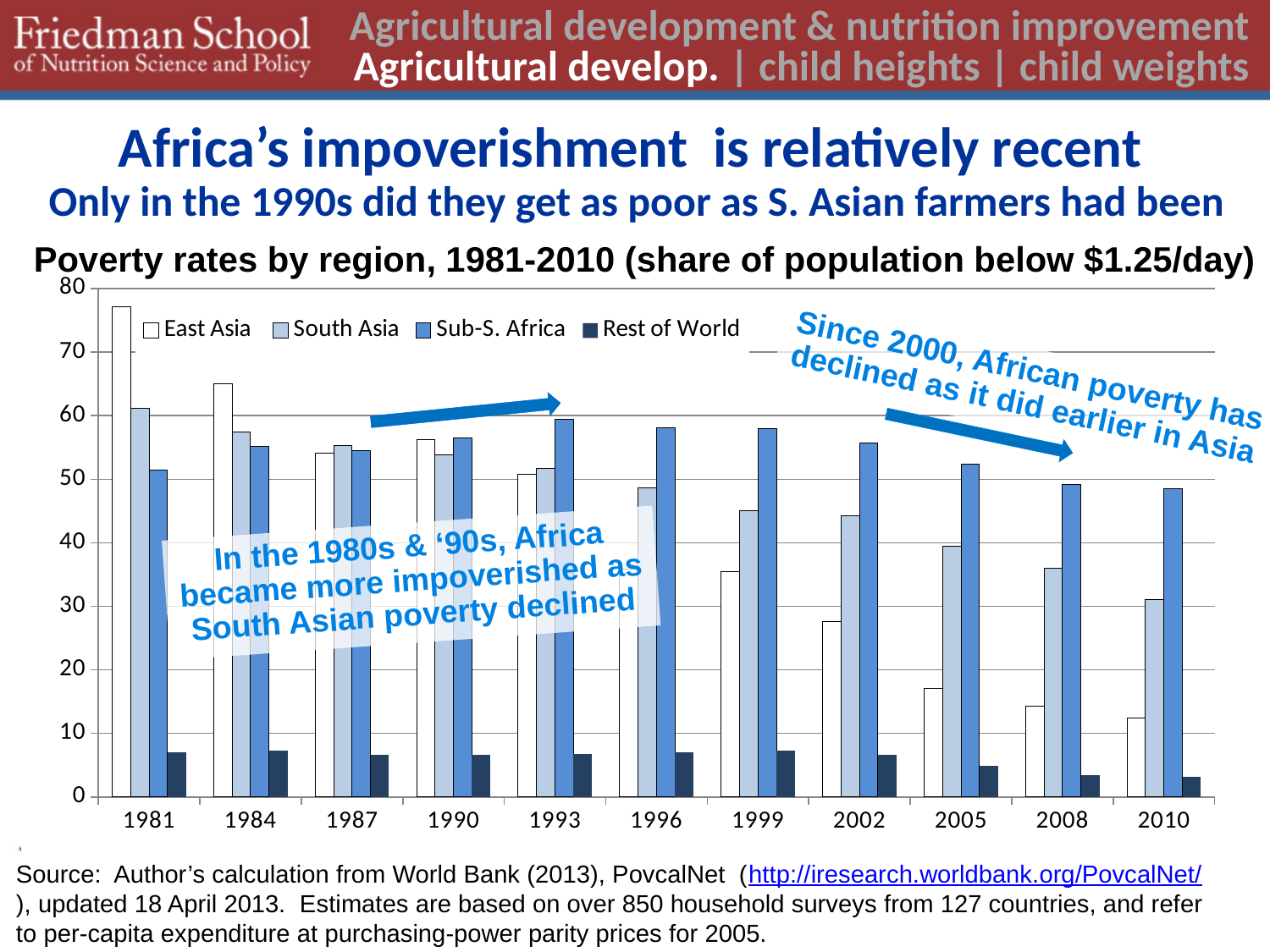
Which region has the lowest poverty rate in 2010? Rest of World What is the title of the chart? Poverty rates by region, 1981-2010 (share of population below $1.25/day) Which region has the highest poverty rate in 1981? East Asia Is the value for East Asia in 1981 greater or less than 70? greater How many years are shown along the x axis? 11 Which region has the highest poverty rate in 2010? Sub-S. Africa Does the East Asia poverty rate rise or fall from 1981 to 2010? Fall How many series does the legend list? 4 In 2010, which is larger: the value for South Asia or the value for Sub-S. Africa? Sub-S. Africa What kind of chart is shown on the slide? Bar chart Is the value for Sub-S. Africa in 2010 greater or less than 50? less Is the value for East Asia in 2010 greater or less than 20? less